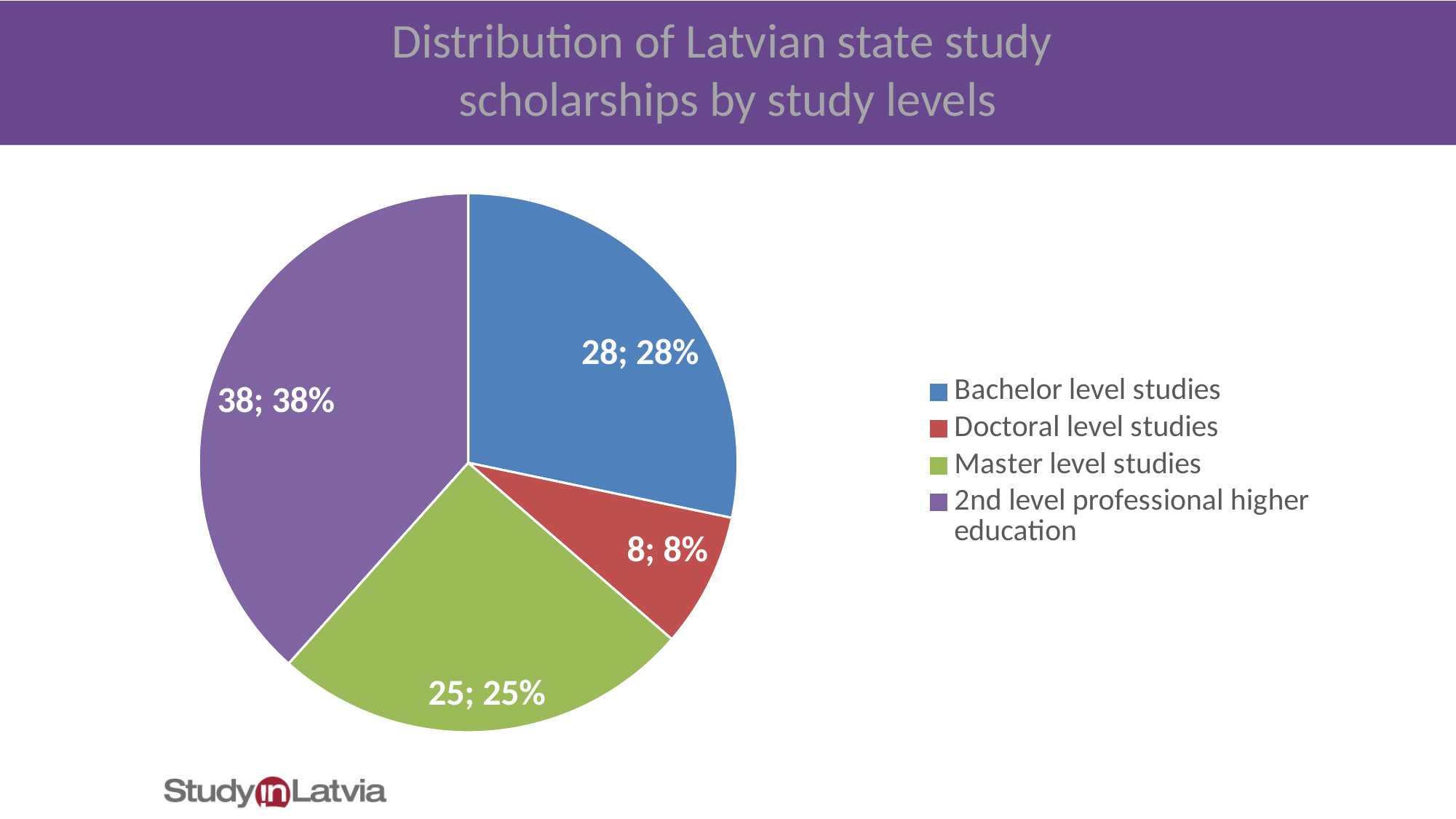
Which category has the smallest slice? Doctoral level studies Which category has the largest slice? 2nd level professional higher education How many categories does the pie chart have? 4 What is the value for Bachelor level studies? 28 What colour is the slice for Master level studies? Green Which is larger, Bachelor level studies or Master level studies? Bachelor level studies What percentage share does Doctoral level studies have? 8% What percentage share does 2nd level professional higher education have? 38% What is the difference between the values for 2nd level professional higher education and Bachelor level studies? 10 What is the title of the chart? Distribution of Latvian state study scholarships by study levels What kind of chart is shown on the slide? Pie chart What is the value for Master level studies? 25